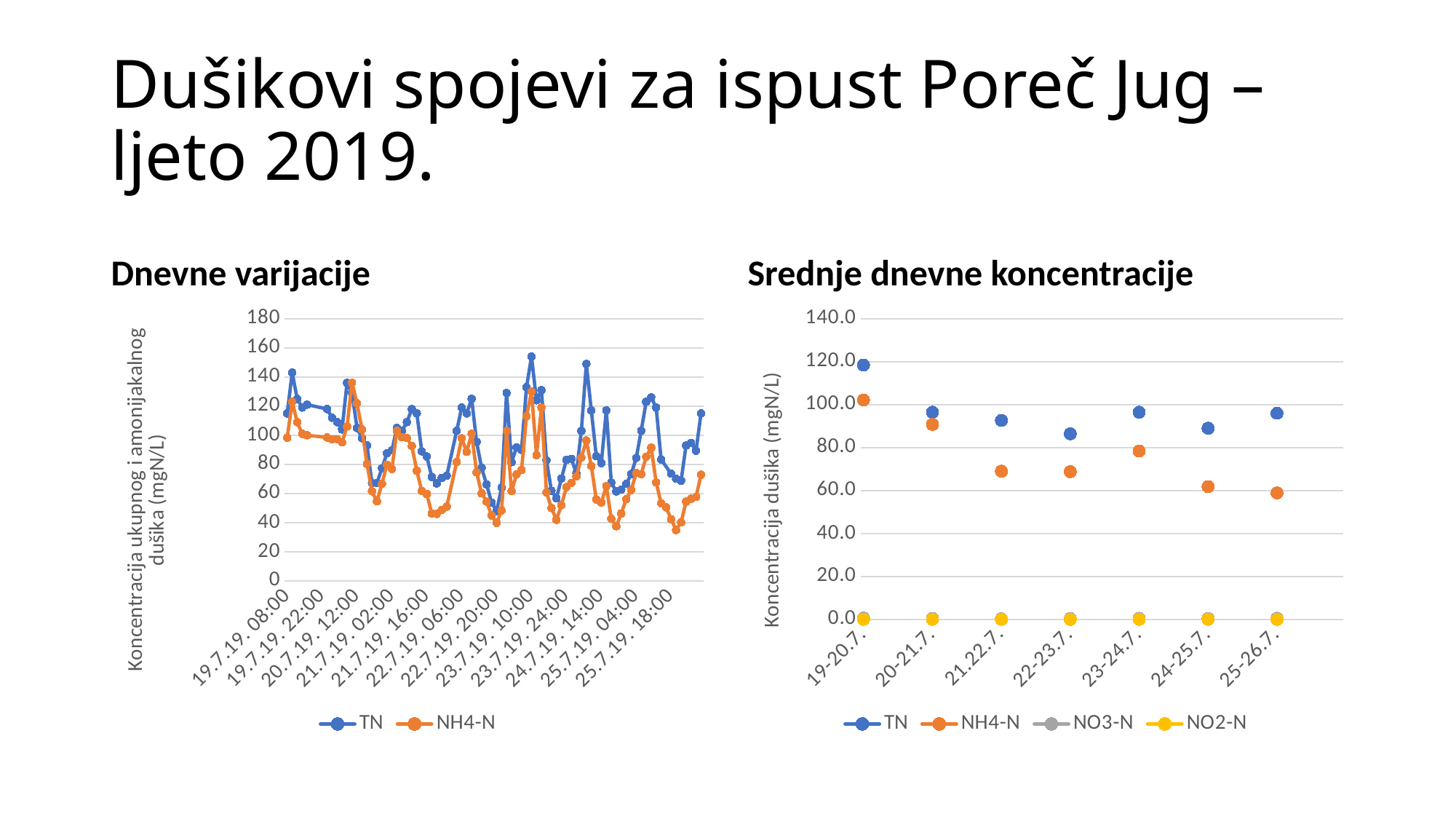
On the 'Srednje dnevne koncentracije' chart, which is larger for 21.22.7., TN or NH4-N? TN What is the y-axis label of the 'Srednje dnevne koncentracije' chart? Koncentracija dušika (mgN/L) On the 'Srednje dnevne koncentracije' chart, how many series does the legend list? 4 On the 'Srednje dnevne koncentracije' chart, how many date categories are shown on the x axis? 7 On the 'Srednje dnevne koncentracije' chart, is the TN value for 19-20.7. greater or less than 100.0? greater On the 'Srednje dnevne koncentracije' chart, which date has the highest TN value? 19-20.7. On the 'Srednje dnevne koncentracije' chart, is the NH4-N value larger for 19-20.7. or for 23-24.7.? 19-20.7. What kind of chart is the 'Dnevne varijacije' chart? line chart On the 'Dnevne varijacije' chart, how many series does the legend list? 2 On the 'Srednje dnevne koncentracije' chart, is the NH4-N value for 21.22.7. greater or less than 80.0? less On the 'Srednje dnevne koncentracije' chart, is the TN value for 22-23.7. greater or less than 80.0? greater On the 'Srednje dnevne koncentracije' chart, which date has the highest NH4-N value? 19-20.7.